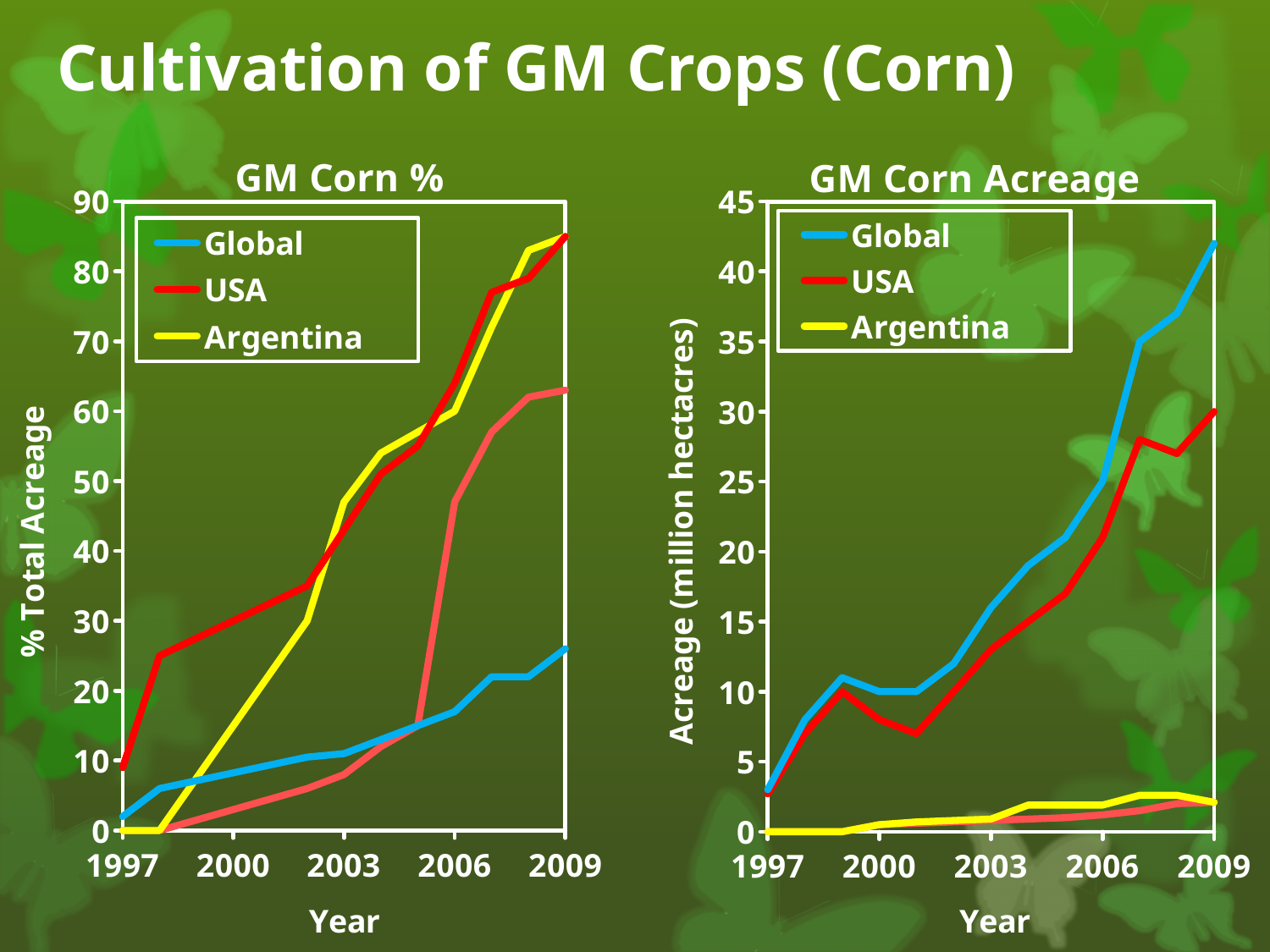
What is the y-axis label of the GM Corn Acreage chart? Acreage (million hectacres) In the GM Corn Acreage chart, which is larger in 2009, Global or USA? Global In the GM Corn Acreage chart, does the Global series rise or fall from 1997 to 2009? rise What kind of chart is the GM Corn % chart? line chart In the GM Corn Acreage chart, is the value for Global in 2009 greater or less than 40? greater In the GM Corn % chart, is the value for USA in 2009 greater or less than 80? greater In the GM Corn % chart, is the value for Global in 2009 greater or less than 30? less In the GM Corn % chart, which of the legend series has the lowest value in 2009? Global In the GM Corn Acreage chart, which series has the highest value in 2009? Global How many series does the legend of the GM Corn Acreage chart list? 3